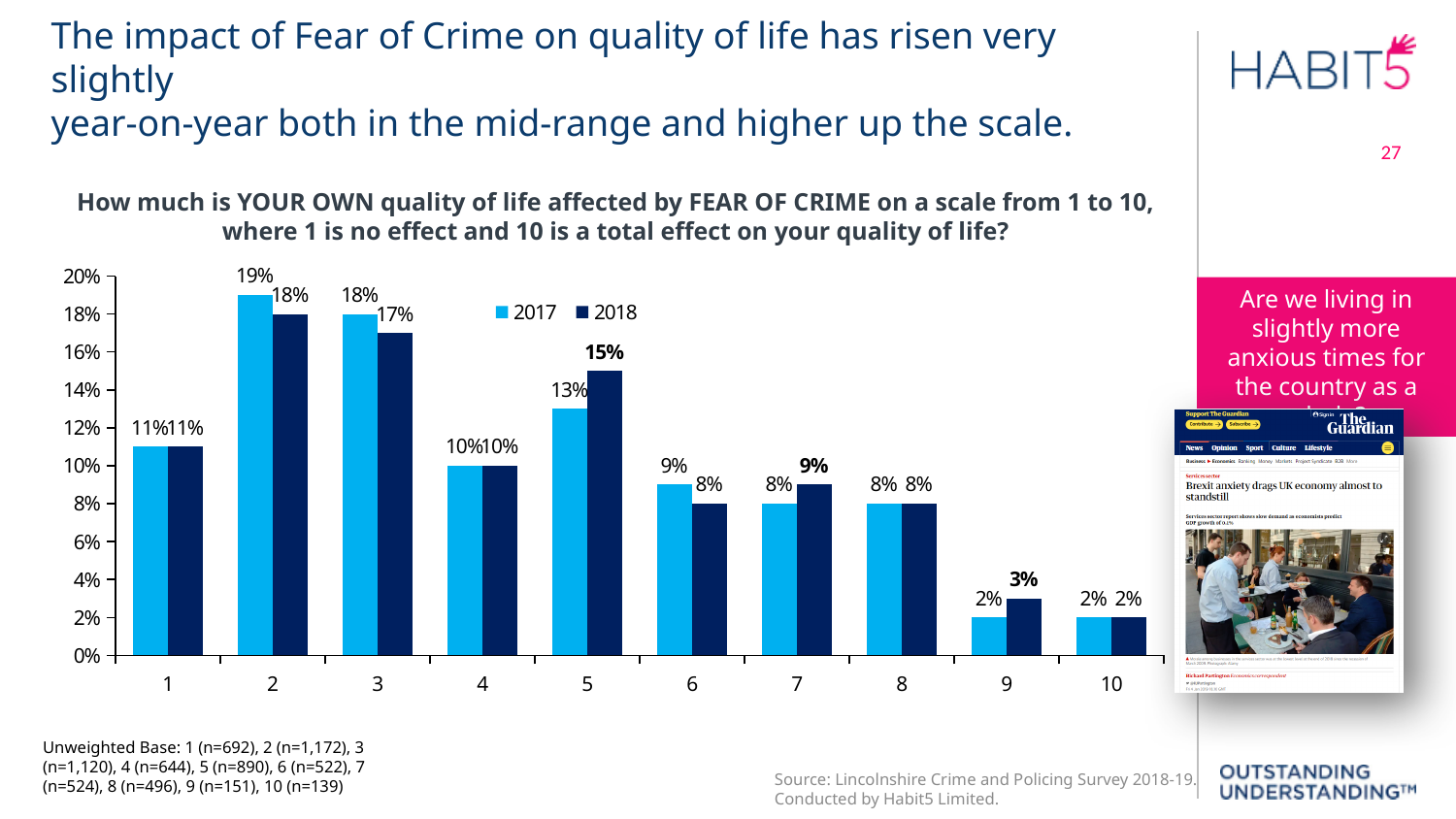
How many series does the legend list? 2 What is the 2018 value for scale point 5? 15% What kind of chart is shown on the slide? bar chart What is the 2018 value for scale point 9? 3% Which series is shown in the lighter blue colour? 2017 What is the 2017 value for scale point 2? 19% What is the difference between the 2018 and 2017 values for scale point 5? 2% Is the 2017 value for scale point 6 greater or less than 10%? less How many scale-point categories are shown on the x axis? 10 For scale point 3, which year has the larger value, 2017 or 2018? 2017 Which scale point has the highest 2017 value? 2 Which scale point has the lowest 2018 value? 10